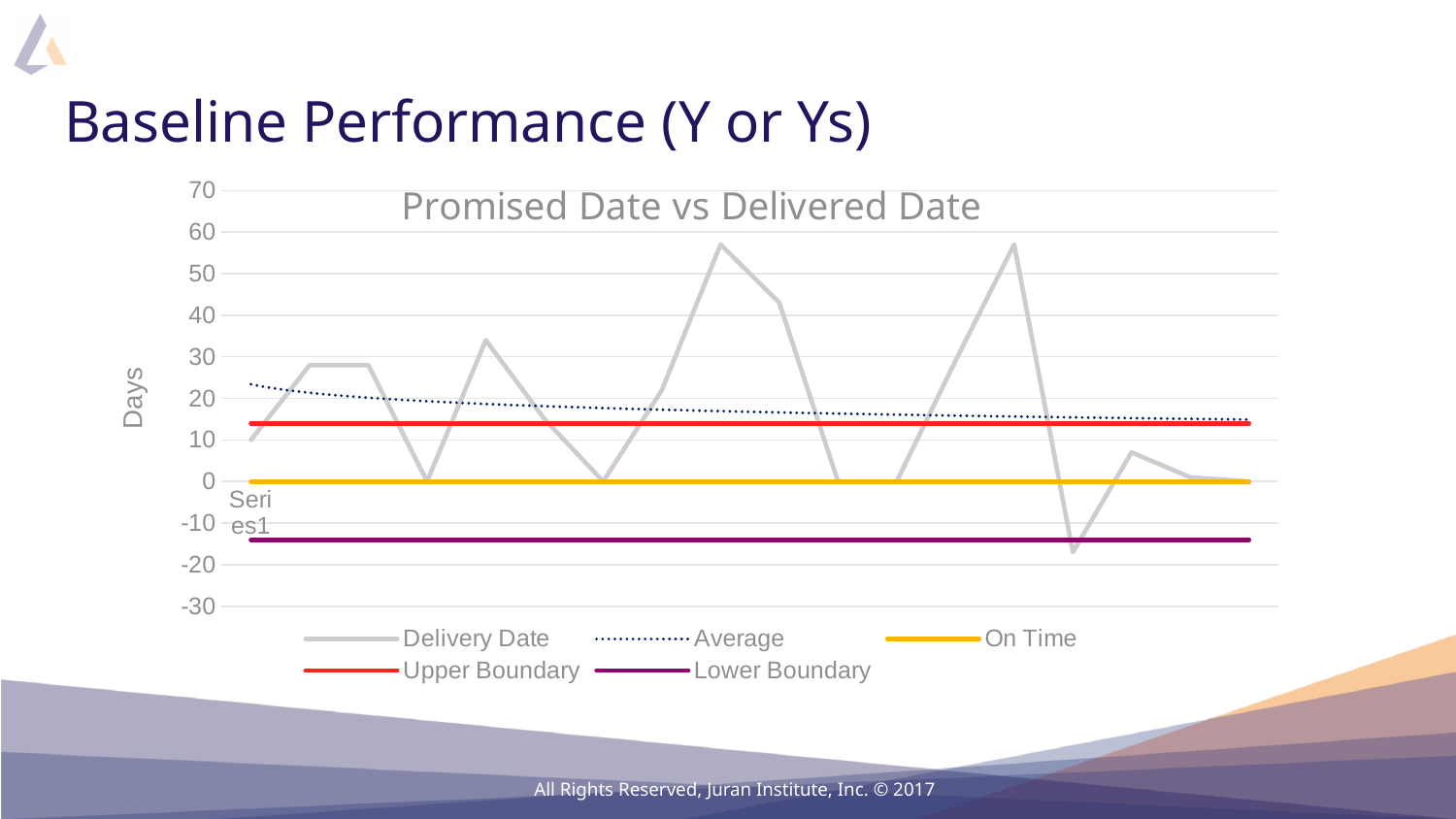
Is the Lower Boundary line greater or less than -10 days? less At what value on the Days axis does the On Time line sit? 0 What kind of chart is shown on the slide? line chart What is the title of the chart? Promised Date vs Delivered Date Does the Average line rise or fall from left to right across the chart? fall Is the highest peak of the Delivery Date line greater or less than 50 days? greater How many series does the chart legend list? 5 Which is higher on the chart, the Upper Boundary line or the Lower Boundary line? Upper Boundary Is the Upper Boundary line greater or less than 10 days? greater What is the label on the vertical axis of the chart? Days